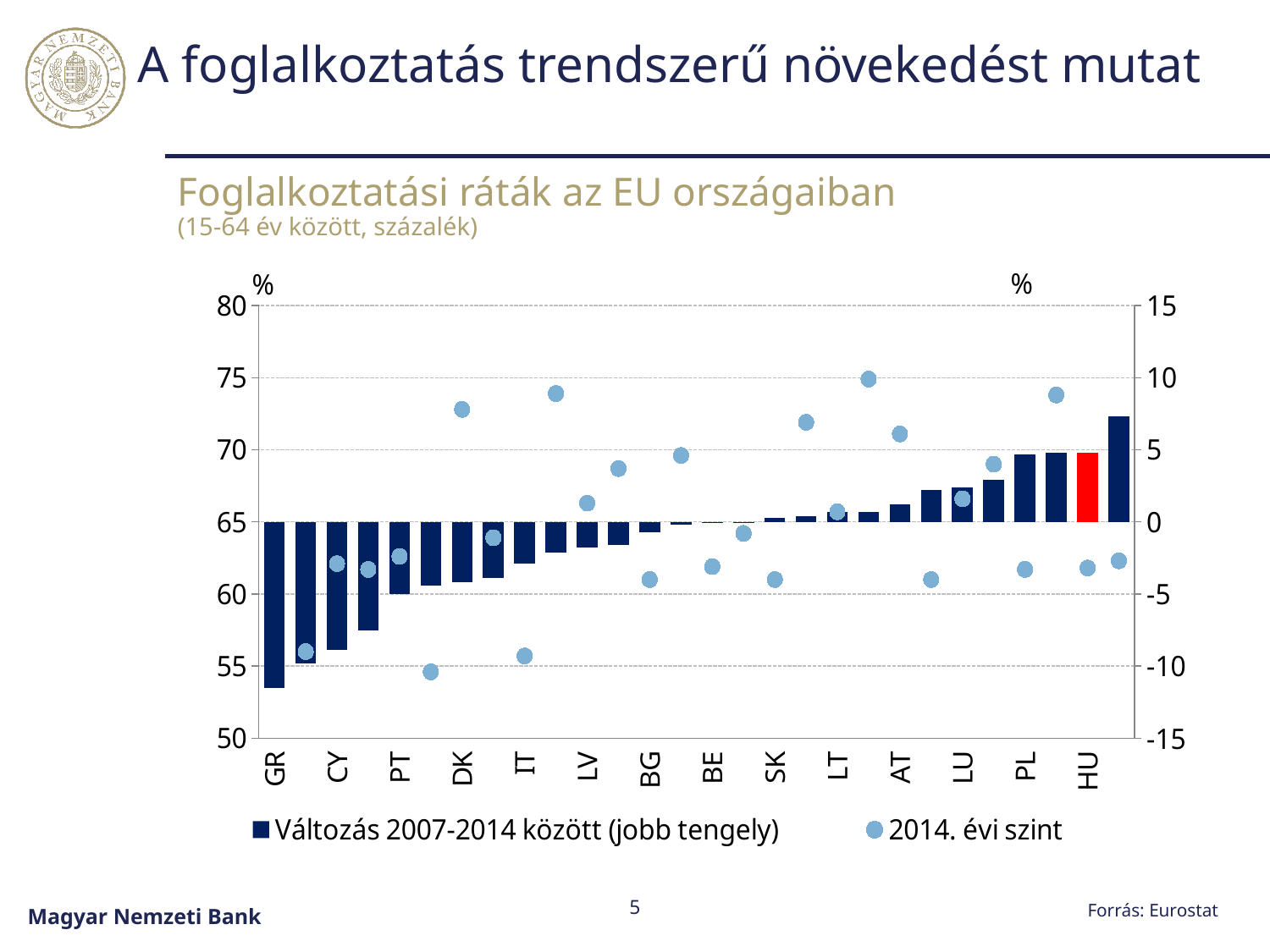
Which has the higher '2014. évi szint' value, DK or IT? DK Is the 'Változás 2007-2014 között' bar for GR greater or less than -10 on the right axis? less What is the title of the chart on the slide? Foglalkoztatási ráták az EU országaiban What kind of chart is shown on the slide? Bar chart combined with a dot (marker) series Do the bars for 'Változás 2007-2014 között' rise or fall from left to right along the x axis? rise How many series does the chart legend list? 2 Is the '2014. évi szint' value for IT greater or less than 60%? less Which labelled country has the lowest bar for 'Változás 2007-2014 között'? GR Is the '2014. évi szint' value for DK greater or less than 70%? greater Which has the larger 'Változás 2007-2014 között' bar, CY or LU? LU Which country's bar is highlighted in red on the chart? HU